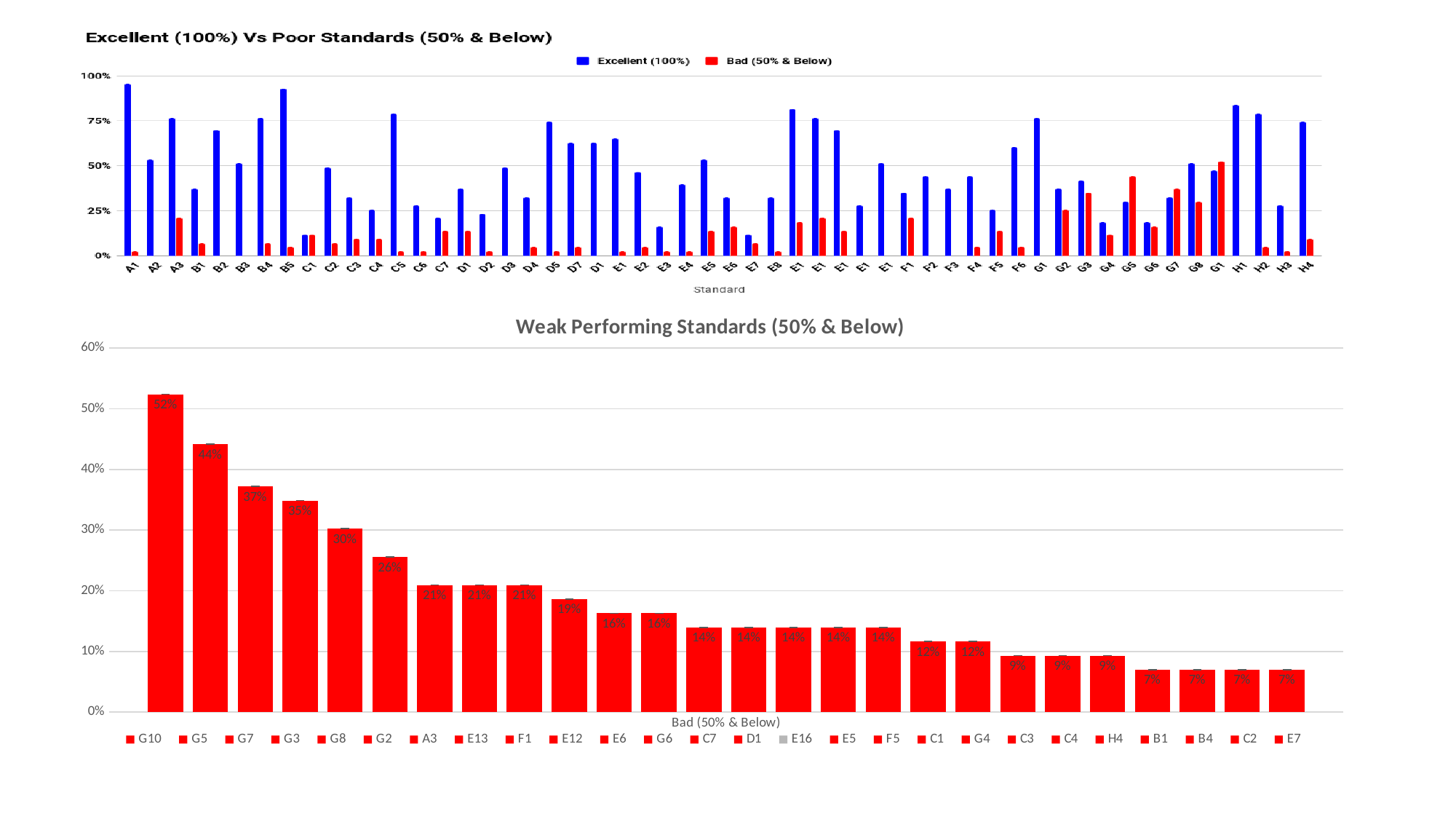
In the top chart, is the Excellent (100%) value for C1 greater or less than 25%? less In the top chart, is the Excellent (100%) value for A1 greater or less than 75%? greater In the bottom chart "Weak Performing Standards (50% & Below)", what is the value of the shortest bars? 7% In the top chart, which has the larger Excellent (100%) value, A1 or A2? A1 In the top chart titled "Excellent (100%) Vs Poor Standards (50% & Below)", how many series does the legend list? 2 What kind of chart is the bottom chart titled "Weak Performing Standards (50% & Below)"? bar chart In the bottom chart "Weak Performing Standards (50% & Below)", do the values rise or fall from left to right? fall In the bottom chart "Weak Performing Standards (50% & Below)", how many bars are plotted? 26 In the top chart, what are the two legend entries? Excellent (100%) and Bad (50% & Below) In the top chart, what is the x-axis title? Standard In the bottom chart "Weak Performing Standards (50% & Below)", what is the value of the tallest bar? 52% In the top chart, is the Bad (50% & Below) value for G5 greater or less than 25%? greater